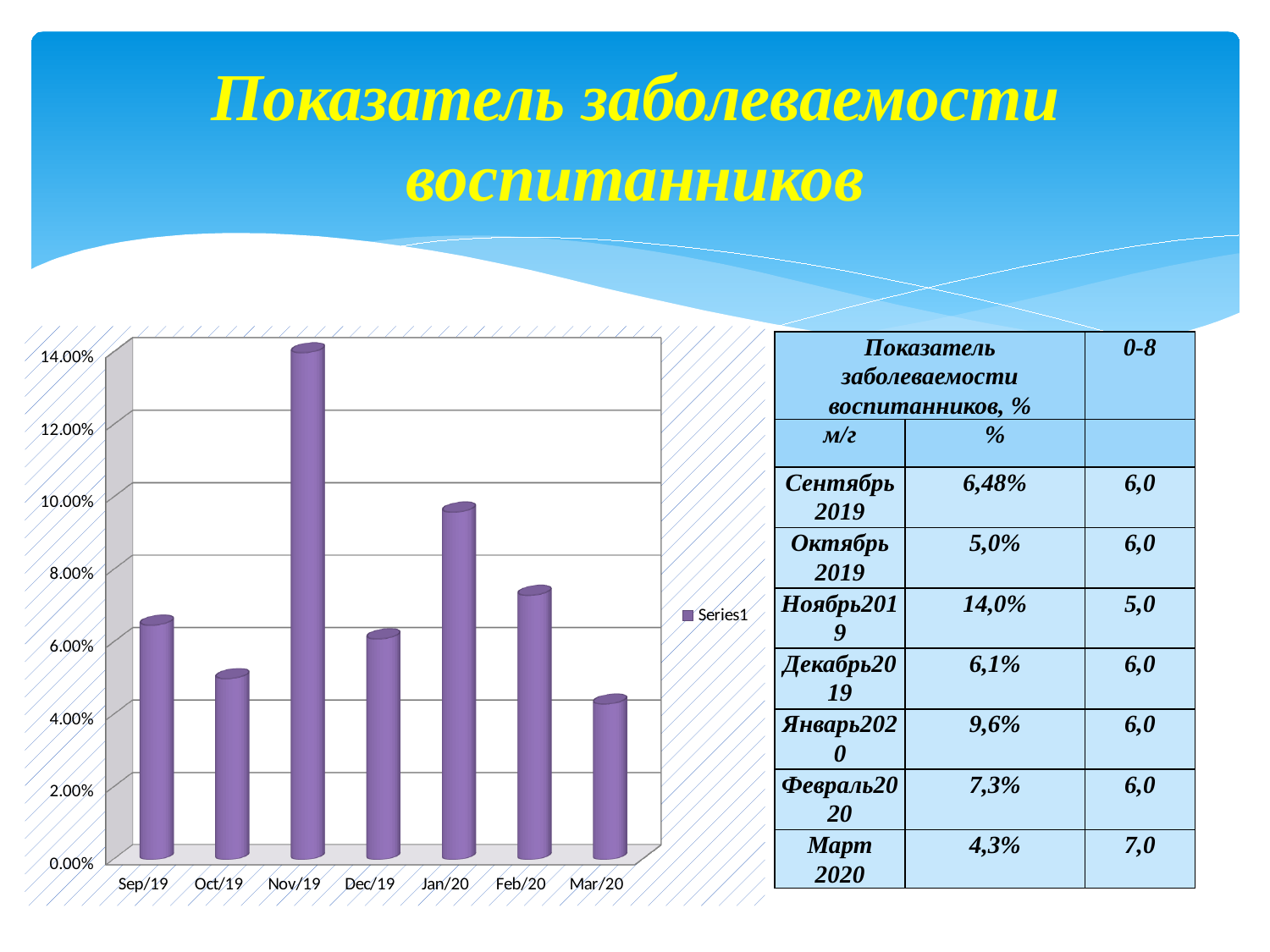
Is the value for Feb/20 greater or less than 6.00%? greater Which month has the lowest bar in the chart? Mar/20 Which is larger in the chart, the value for Jan/20 or the value for Feb/20? Jan/20 Is the value for Nov/19 greater or less than 12.00%? greater What kind of chart is shown on the slide? bar chart How many series does the chart legend list? 1 Which is larger in the chart, the value for Sep/19 or the value for Oct/19? Sep/19 Which month has the highest bar in the chart? Nov/19 Is the value for Jan/20 greater or less than 10.00%? less What is the name of the series shown in the chart legend? Series1 How many months are plotted on the x axis of the chart? 7